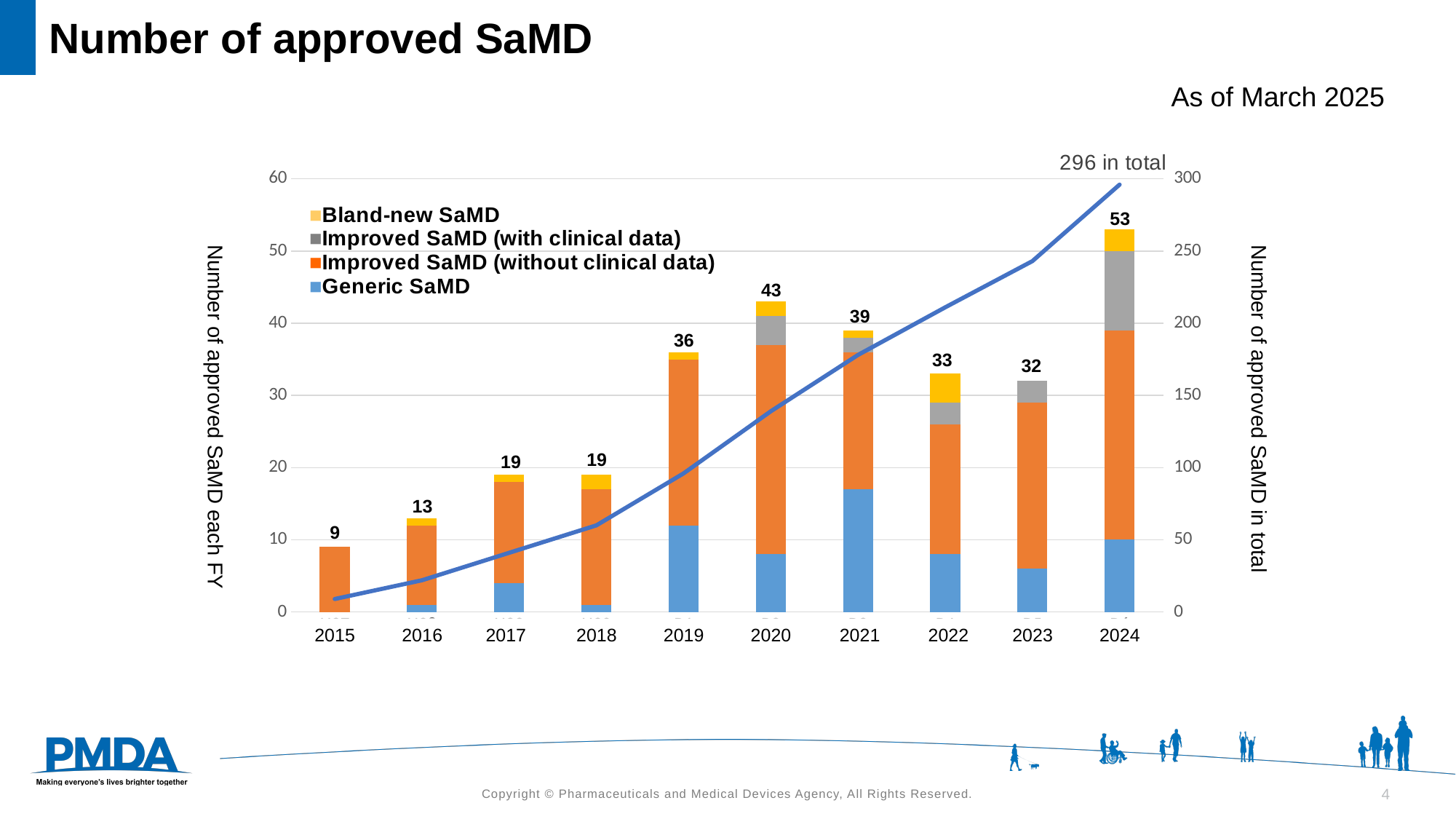
How many series does the legend list? 4 What kind of chart is used to show the number of approved SaMD each FY? Stacked bar chart What is the difference between the total approved SaMD in FY 2024 and FY 2020? 10 What is the cumulative total of approved SaMD stated on the chart? 296 in total What is the total number of approved SaMD in FY 2024? 53 Which fiscal year had more approved SaMD, 2019 or 2021? 2021 What is the total number of approved SaMD in FY 2019? 36 Which fiscal year has the lowest number of approved SaMD? 2015 How many fiscal years are shown on the x axis? 10 Is the value for Generic SaMD in FY 2021 greater or less than 10? greater Does the line for the number of approved SaMD in total rise or fall from 2015 to 2024? Rises Which fiscal year has the highest number of approved SaMD? 2024